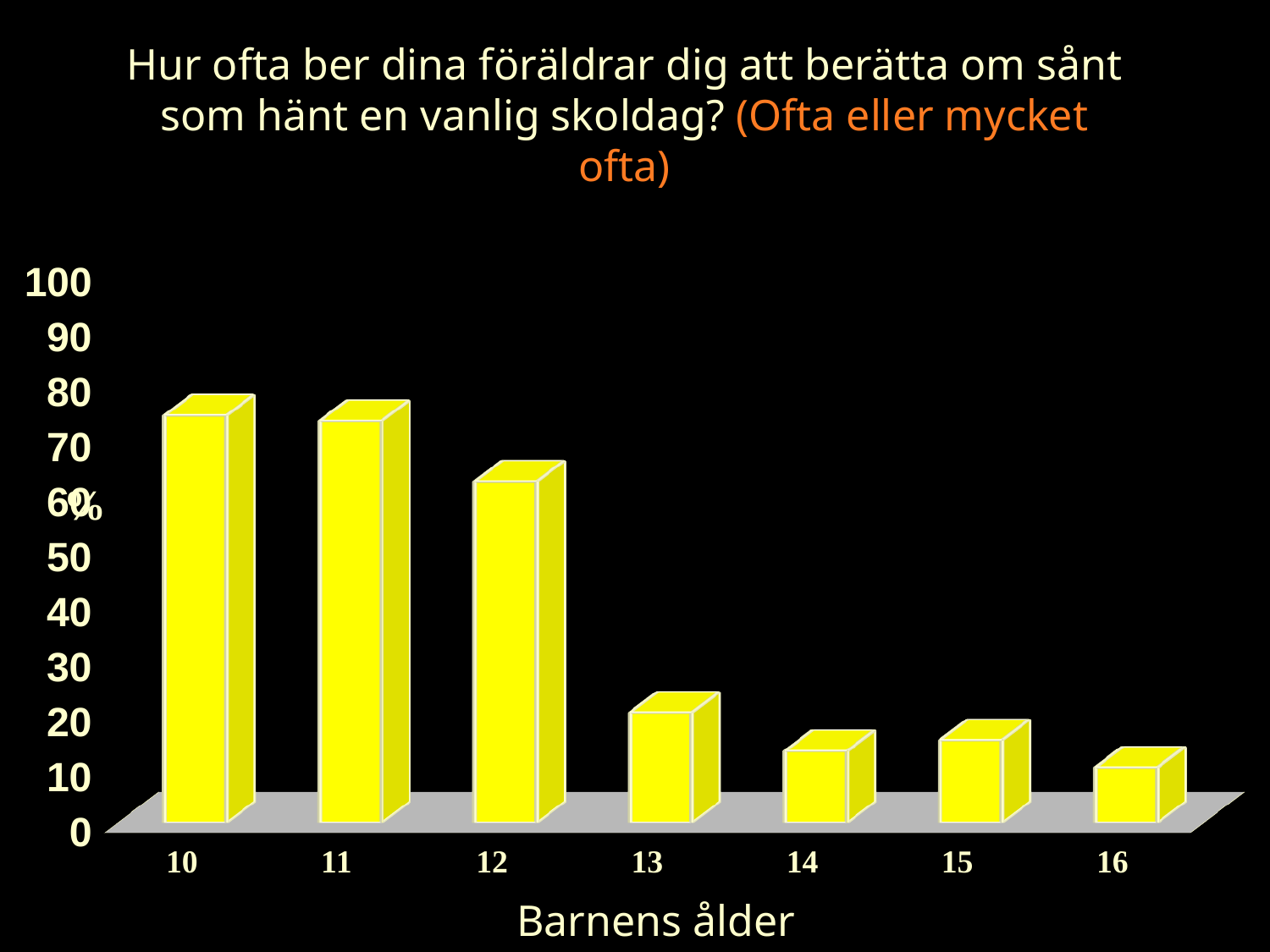
Is the value for age 12 greater or less than 50? greater Is the value for age 10 greater or less than 70? greater Is the value for age 16 greater or less than 20? less Do the values generally rise or fall as the children's age increases along the x axis? fall What colour are the bars in the chart? yellow What is the title of the x axis? Barnens ålder Which has the larger value, age 12 or age 13? 12 How many age categories are shown on the x axis? 7 Which has the larger value, age 15 or age 16? 15 What kind of chart is shown on the slide? bar chart